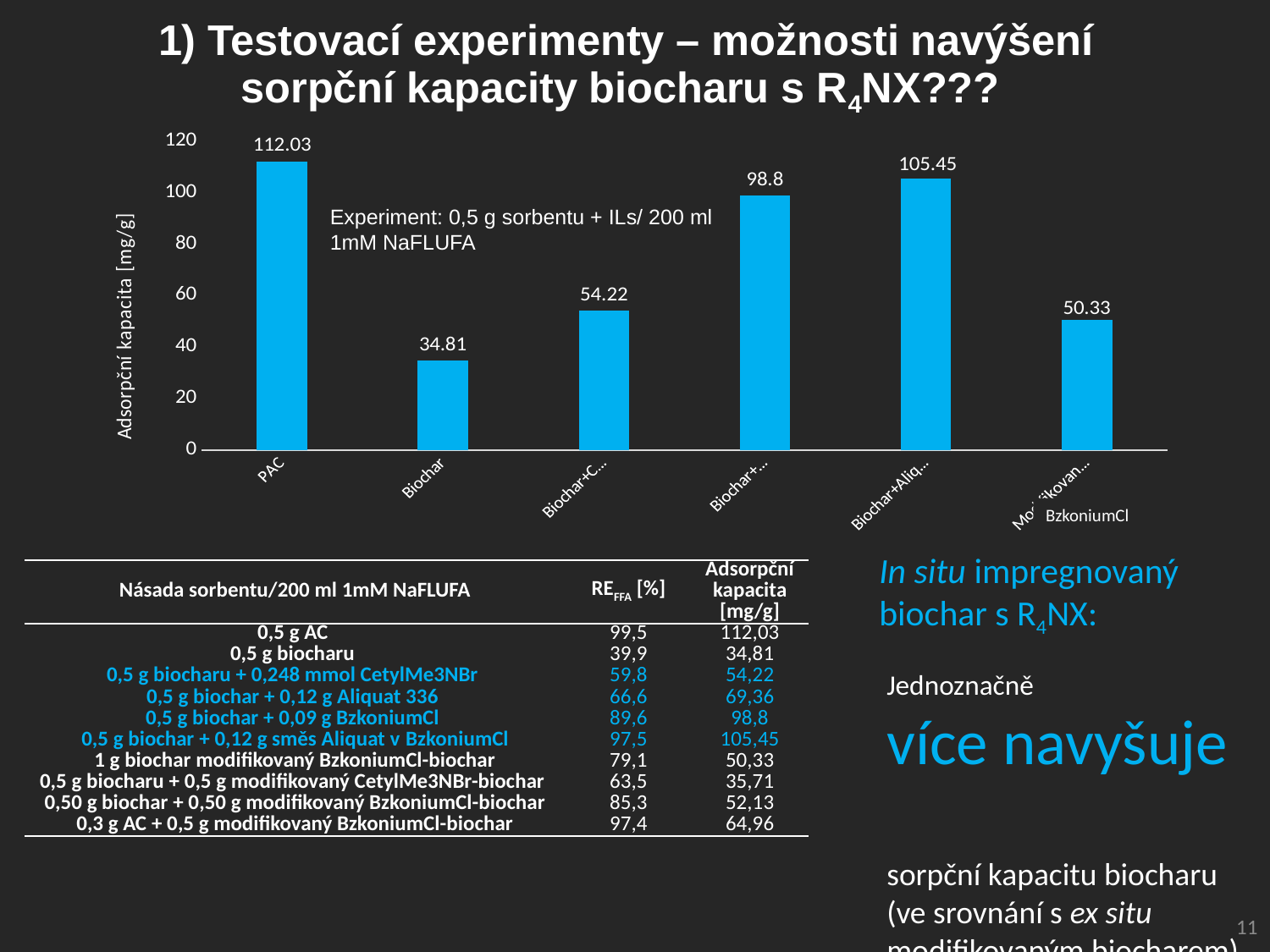
What is the value shown on the rightmost bar of the chart? 50.33 What is the adsorption capacity value shown for PAC? 112.03 What is the adsorption capacity value shown for Biochar? 34.81 How many bars are plotted in the chart? 6 What is the title of the vertical axis of the chart? Adsorpční kapacita [mg/g] Which category has the lowest bar in the chart? Biochar What kind of chart is shown on the slide? bar chart Which has a larger value, PAC or Biochar? PAC What is the difference between the values for PAC and Biochar? 77.22 What is the value shown on the fifth bar from the left? 105.45 Which category has the highest bar in the chart? PAC Is the value for the third bar from the left greater or less than 60? less